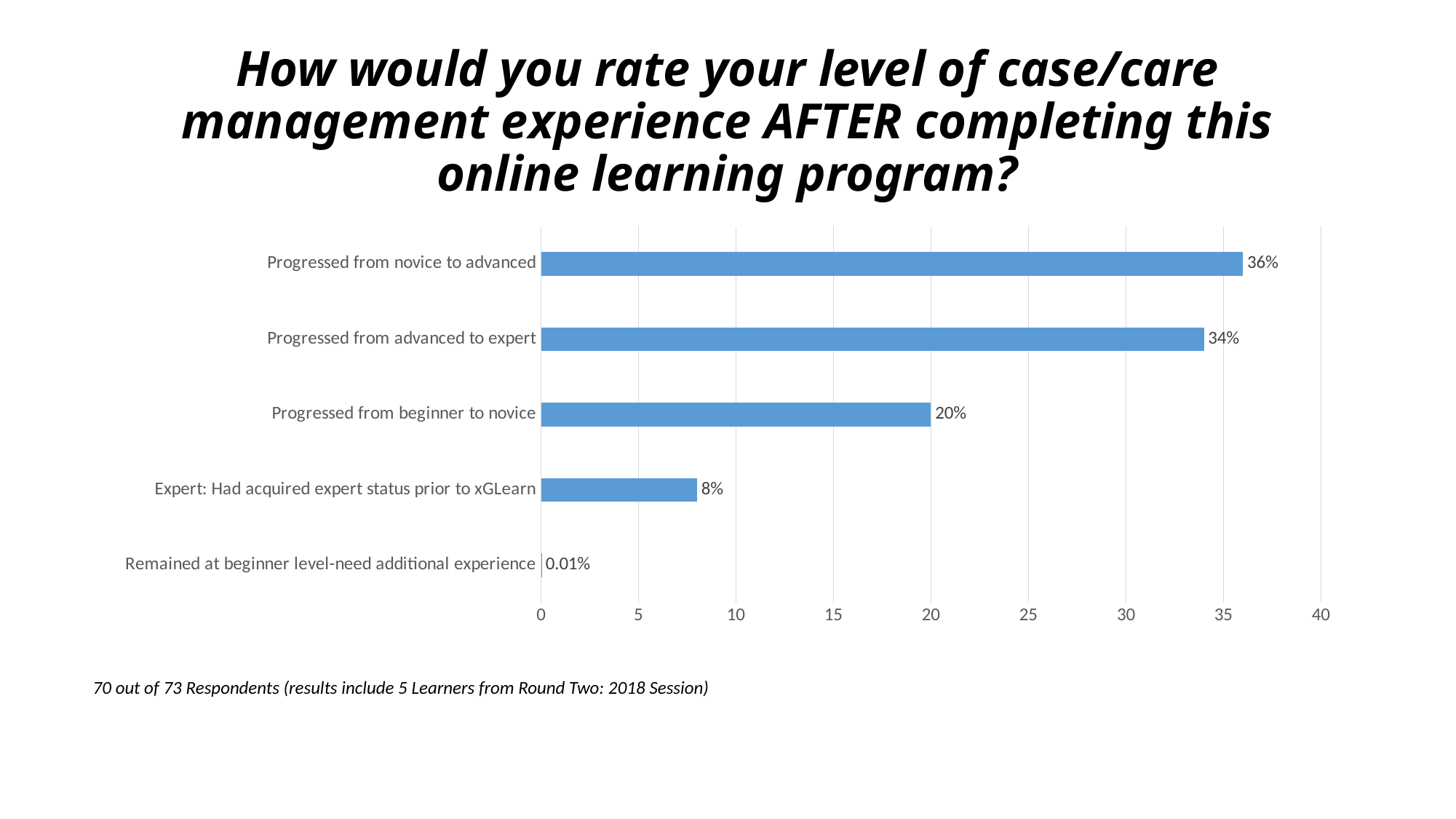
What is the value for 'Expert: Had acquired expert status prior to xGLearn'? 8% What is the difference between 'Progressed from novice to advanced' and 'Progressed from beginner to novice'? 16% What is the value for 'Progressed from novice to advanced'? 36% What is the maximum value shown on the horizontal axis? 40 Which category has the highest value? Progressed from novice to advanced Which category has the lowest value? Remained at beginner level-need additional experience Which is larger: 'Progressed from beginner to novice' or 'Expert: Had acquired expert status prior to xGLearn'? Progressed from beginner to novice What is the value for 'Progressed from advanced to expert'? 34% What is the value for 'Remained at beginner level-need additional experience'? 0.01% What kind of chart is shown on the slide? Bar chart How many categories are shown in the chart? 5 What is the value for 'Progressed from beginner to novice'? 20%